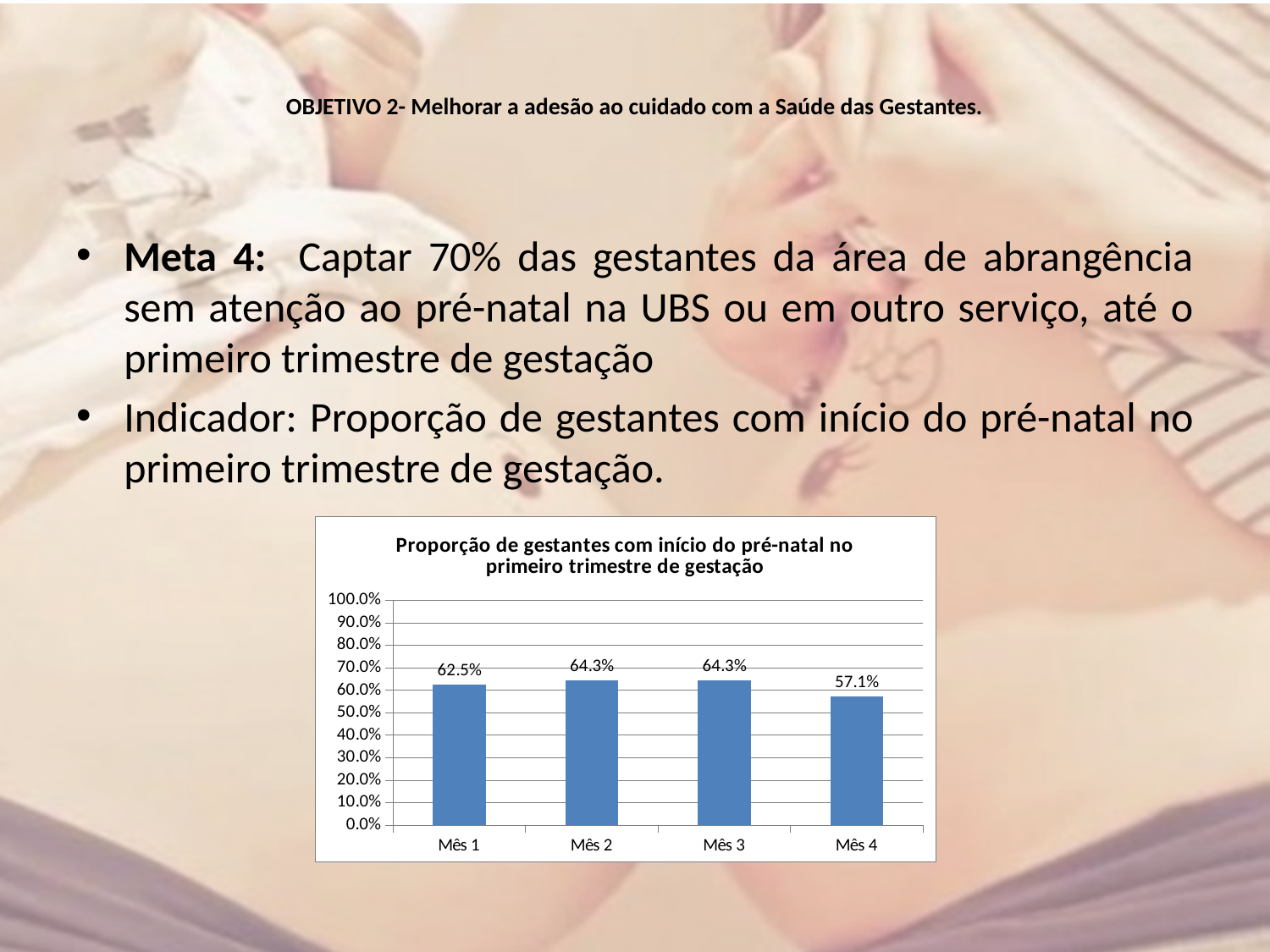
Which month has the lowest value? Mês 4 What is the title of the chart? Proporção de gestantes com início do pré-natal no primeiro trimestre de gestação What is the difference between the values for Mês 2 and Mês 4? 7.2% What is the value for Mês 2? 64.3% What is the value for Mês 4? 57.1% Which is larger, the value for Mês 1 or the value for Mês 4? Mês 1 What is the value for Mês 1? 62.5% How many months are shown on the x axis? 4 What kind of chart is shown on the slide? bar chart What is the difference between the values for Mês 1 and Mês 4? 5.4% Is the value for Mês 3 greater or less than 70%? less Is the value for Mês 4 greater or less than 50%? greater